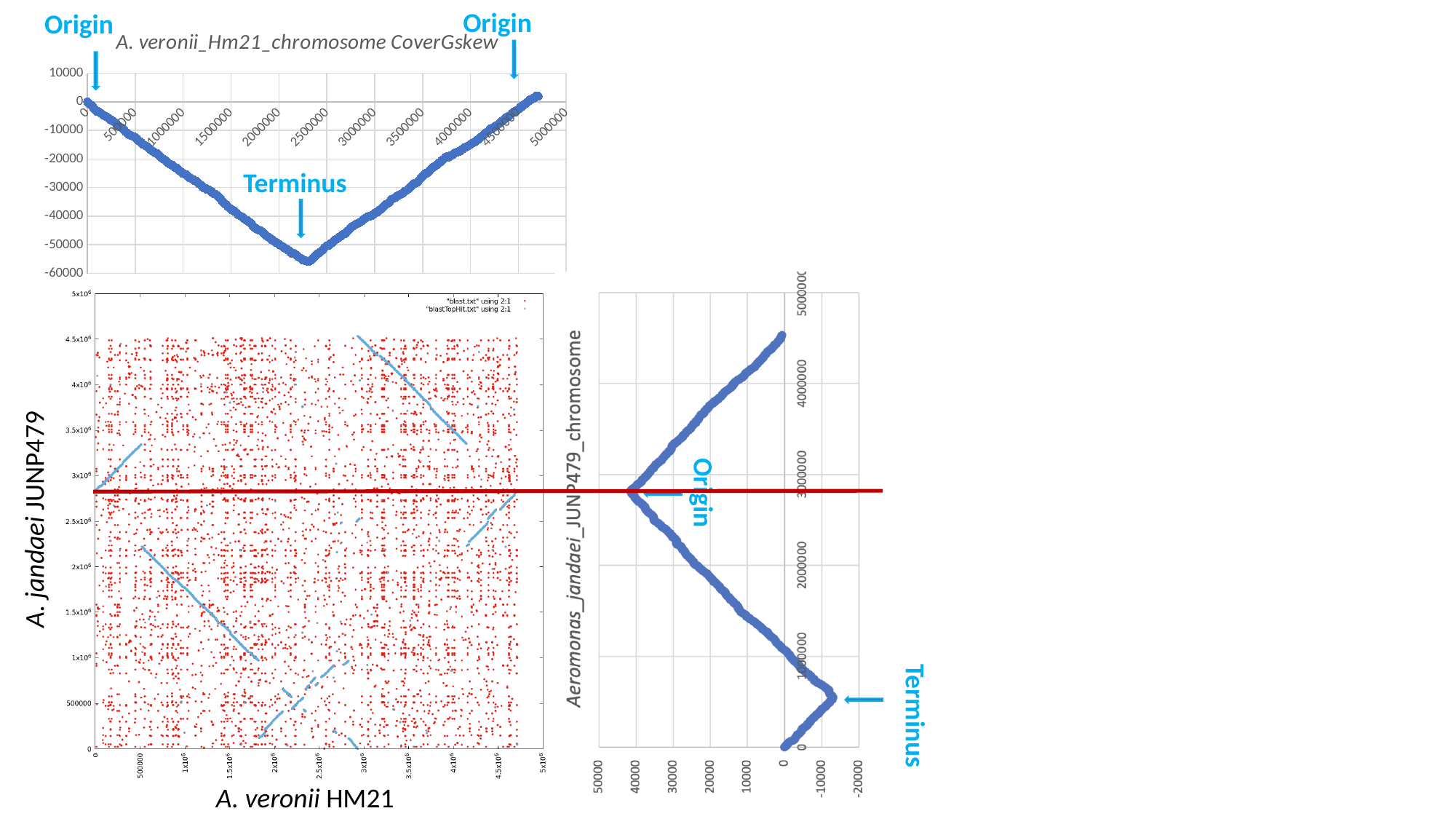
In the bottom-left dot plot, how many series does the legend list? 2 In the top chart (A. veronii_Hm21_chromosome CoverGskew), what is the lowest value shown on the y axis? -60000 In the bottom-right chart (Aeromonas_jandaei_JUNP479_chromosome), is the value at the point labelled Terminus greater or less than 0? less In the top chart (A. veronii_Hm21_chromosome CoverGskew), do the values rise or fall along the x axis between 0 and 2500000? fall In the top chart (A. veronii_Hm21_chromosome CoverGskew), which labelled point, Origin or Terminus, has the lower value? Terminus In the bottom-right chart (Aeromonas_jandaei_JUNP479_chromosome), is the value at the point labelled Origin greater or less than 30000? greater How many charts are shown on the slide? 3 In the top chart (A. veronii_Hm21_chromosome CoverGskew), is the value at the point labelled Terminus greater or less than -50000? less In the bottom-left dot plot, what is the label of the x axis? A. veronii HM21 In the top chart (A. veronii_Hm21_chromosome CoverGskew), do the values rise or fall along the x axis between 2500000 and 5000000? rise In the top chart (A. veronii_Hm21_chromosome CoverGskew), what kind of chart is shown? scatter chart What is the title of the chart at the top of the slide? A. veronii_Hm21_chromosome CoverGskew